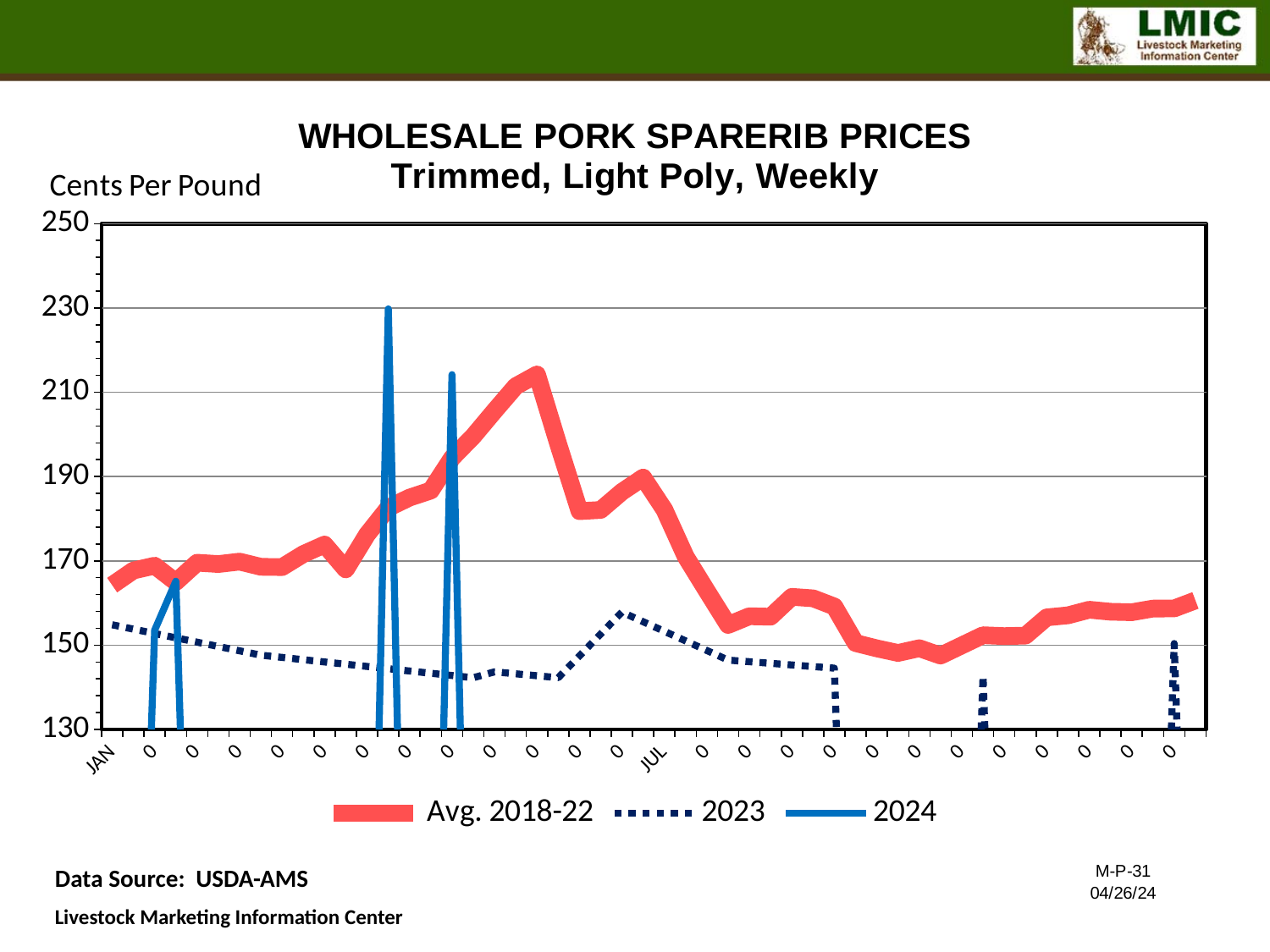
Is the 2023 value at JAN greater or less than 170? less Is the 2023 value at JUL greater or less than 170? less How many series does the legend list? 3 Does the Avg. 2018-22 series generally rise or fall from JAN to its peak before JUL? rise What unit is shown on the y axis of the chart? Cents Per Pound Which series reaches the highest value anywhere on the chart? 2024 At JAN, which series is higher: Avg. 2018-22 or 2023? Avg. 2018-22 Is the highest value of the Avg. 2018-22 series greater or less than 210? greater What is the title of the chart? WHOLESALE PORK SPARERIB PRICES Trimmed, Light Poly, Weekly At JUL, which series is higher: Avg. 2018-22 or 2023? Avg. 2018-22 What kind of chart is shown on the slide? line chart